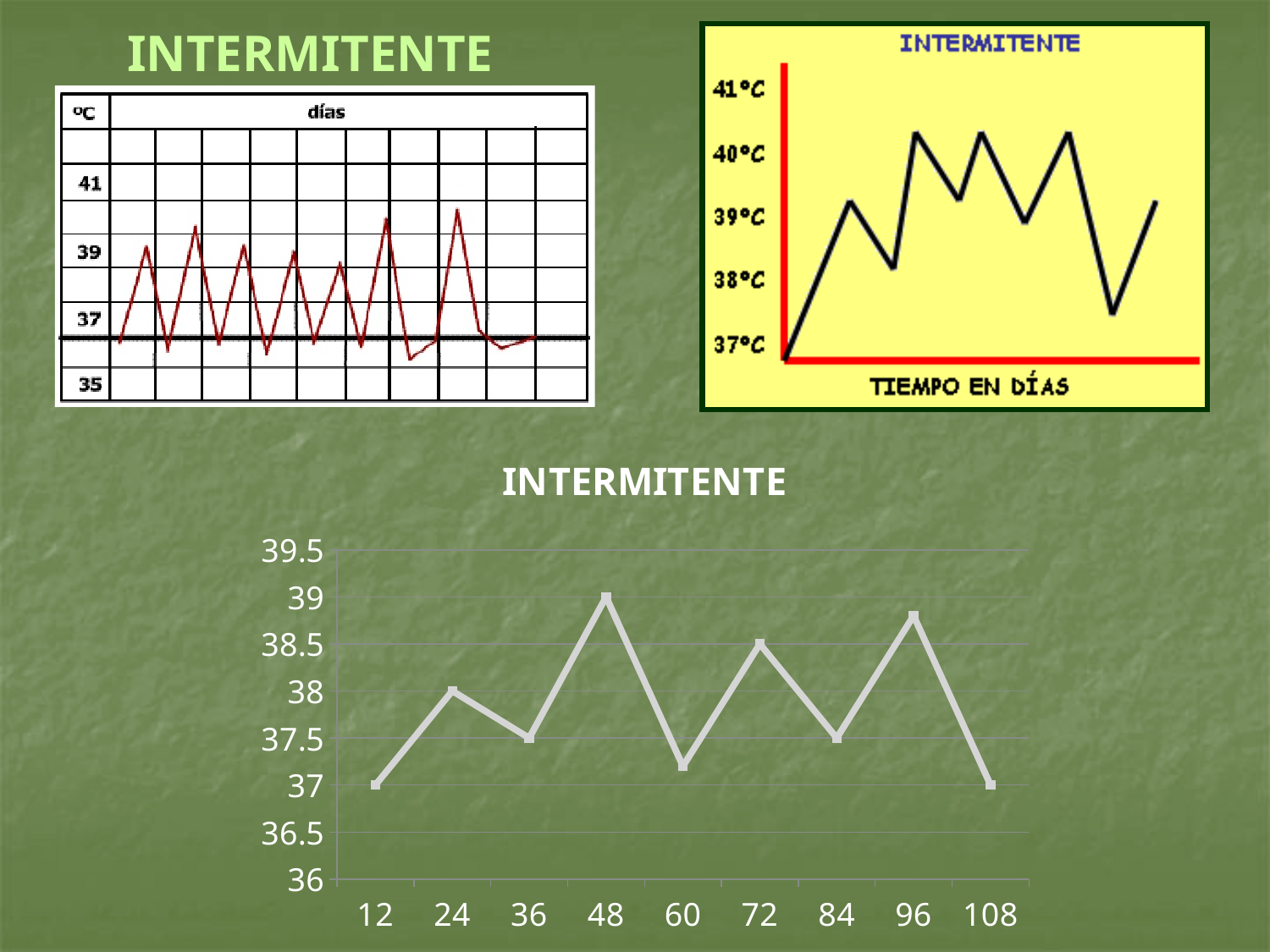
On the bottom chart titled INTERMITENTE, how many data points are plotted? 9 On the bottom chart titled INTERMITENTE, what is the value at 12? 37 On the bottom chart titled INTERMITENTE, which is larger, the value at 48 or the value at 72? 48 On the bottom chart titled INTERMITENTE, at which x-axis value is the highest point? 48 On the bottom chart titled INTERMITENTE, what kind of chart is shown? line chart On the bottom chart titled INTERMITENTE, is the value at 60 greater or less than 37.5? less On the top-right chart titled INTERMITENTE, what is the label of the horizontal axis? TIEMPO EN DÍAS On the bottom chart titled INTERMITENTE, what is the value at 48? 39 On the bottom chart titled INTERMITENTE, what is the value at 24? 38 On the bottom chart titled INTERMITENTE, is the value at 96 greater or less than 38.5? greater On the bottom chart titled INTERMITENTE, what is the value at 72? 38.5 On the bottom chart titled INTERMITENTE, what is the difference between the values at 48 and 24? 1